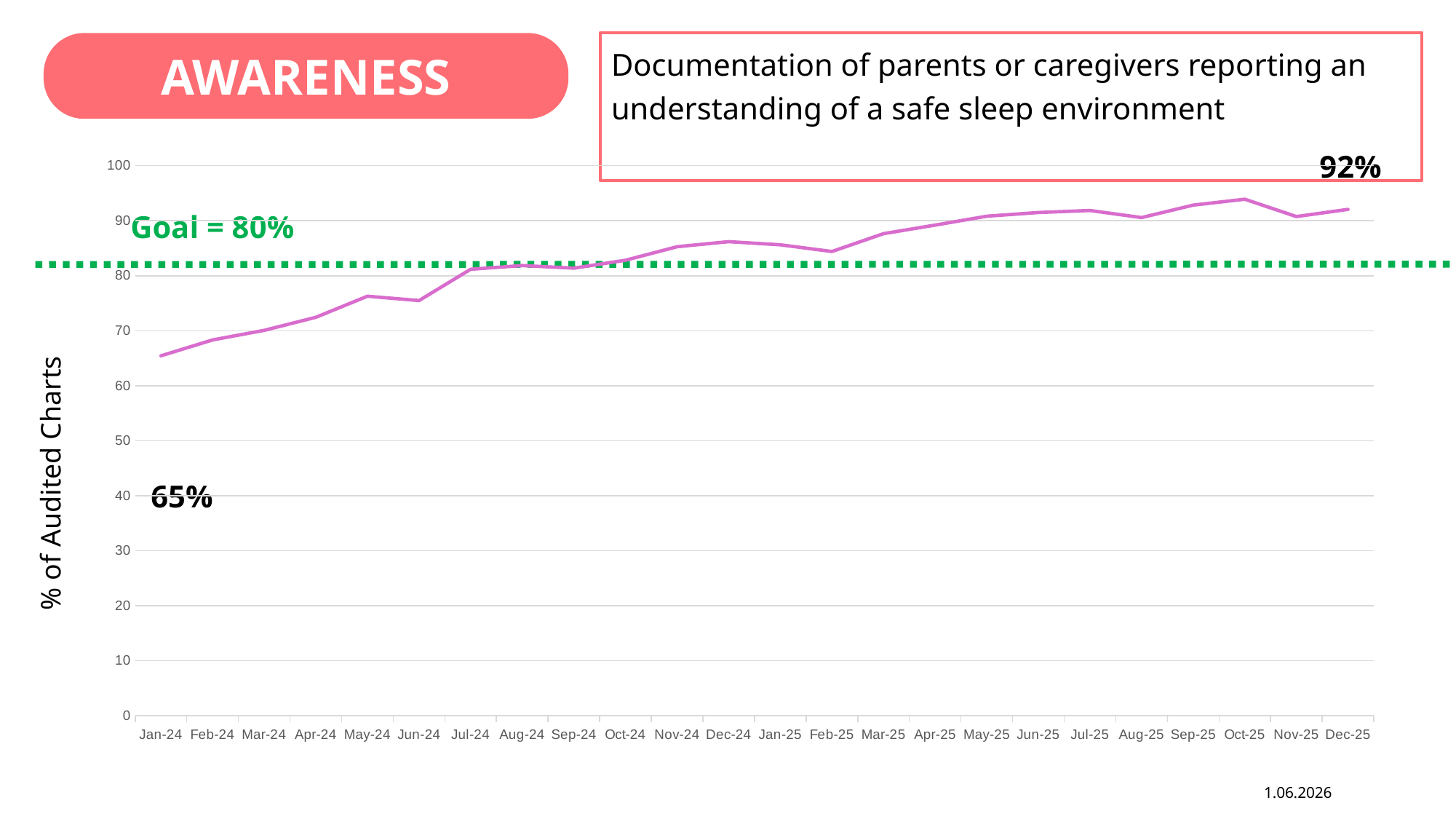
What goal value is marked by the dashed green line? 80% Is the value for Jun-24 greater or less than 70? greater Do the values generally rise or fall from Jan-24 to Dec-25? rise Which is larger, the value for Dec-25 or the value for Jan-24? Dec-25 How many months are plotted on the x axis? 24 What kind of chart is shown on the slide? line chart Which month has the lowest value on the chart? Jan-24 What is the difference between the Dec-25 value and the Jan-24 value? 27 percentage points What is the value for Dec-25? 92% Is the value for Feb-25 greater or less than 80? greater What is the value for Jan-24? 65%